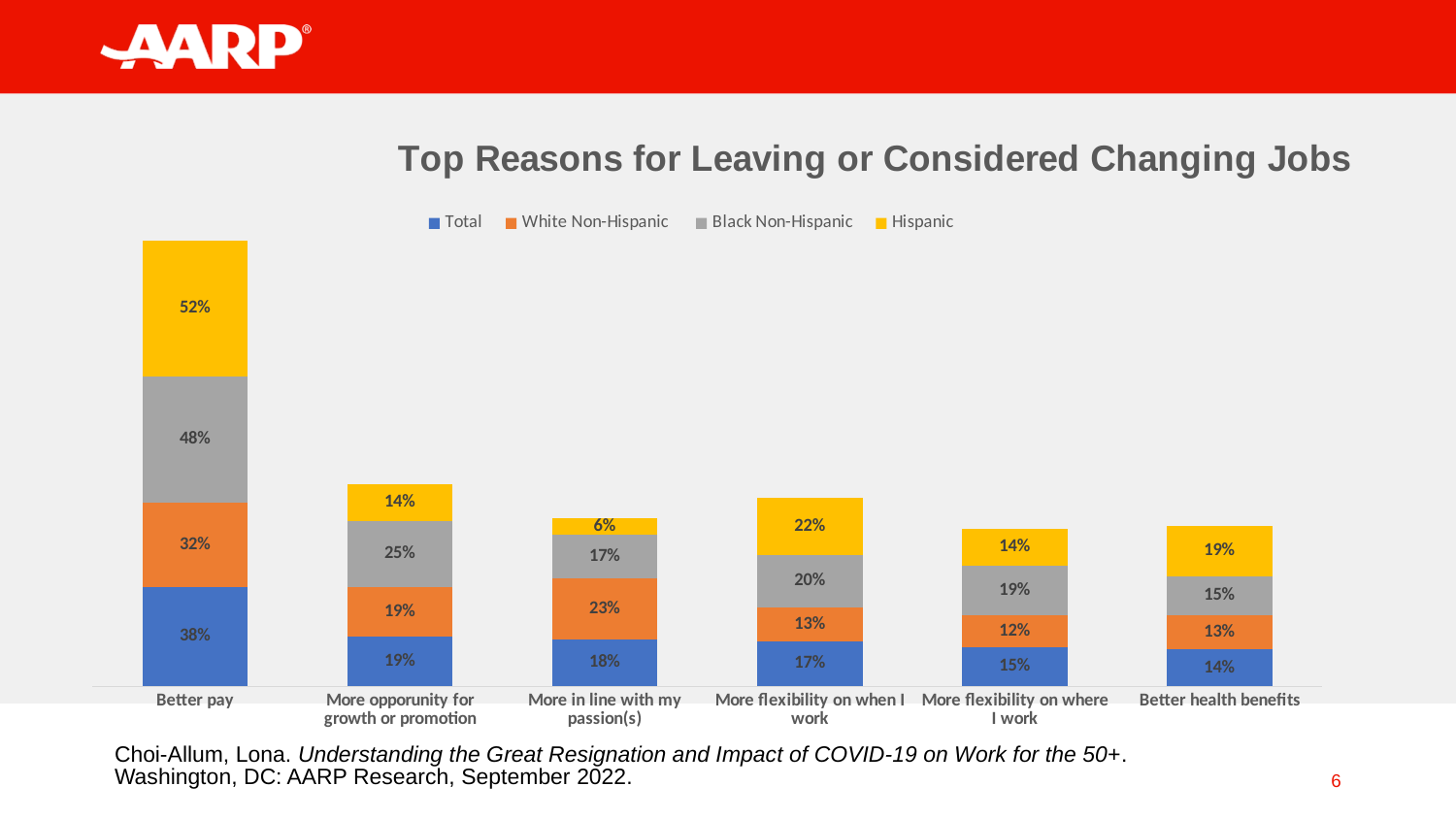
How many series does the legend list? 4 What is the Hispanic value for Better pay? 52% Which category has the lowest Hispanic value? More in line with my passion(s) What is the title of the chart? Top Reasons for Leaving or Considered Changing Jobs What is the Total value for More flexibility on where I work? 15% What kind of chart is shown on the slide? Stacked bar chart Which is larger for Better health benefits: the Hispanic value or the Black Non-Hispanic value? Hispanic What is the White Non-Hispanic value for More in line with my passion(s)? 23% What is the total of the stacked bar for More flexibility on when I work? 72% What is the difference between the Black Non-Hispanic and White Non-Hispanic values for Better pay? 16% Which category has the highest Total value? Better pay How many categories are shown on the x axis? 6